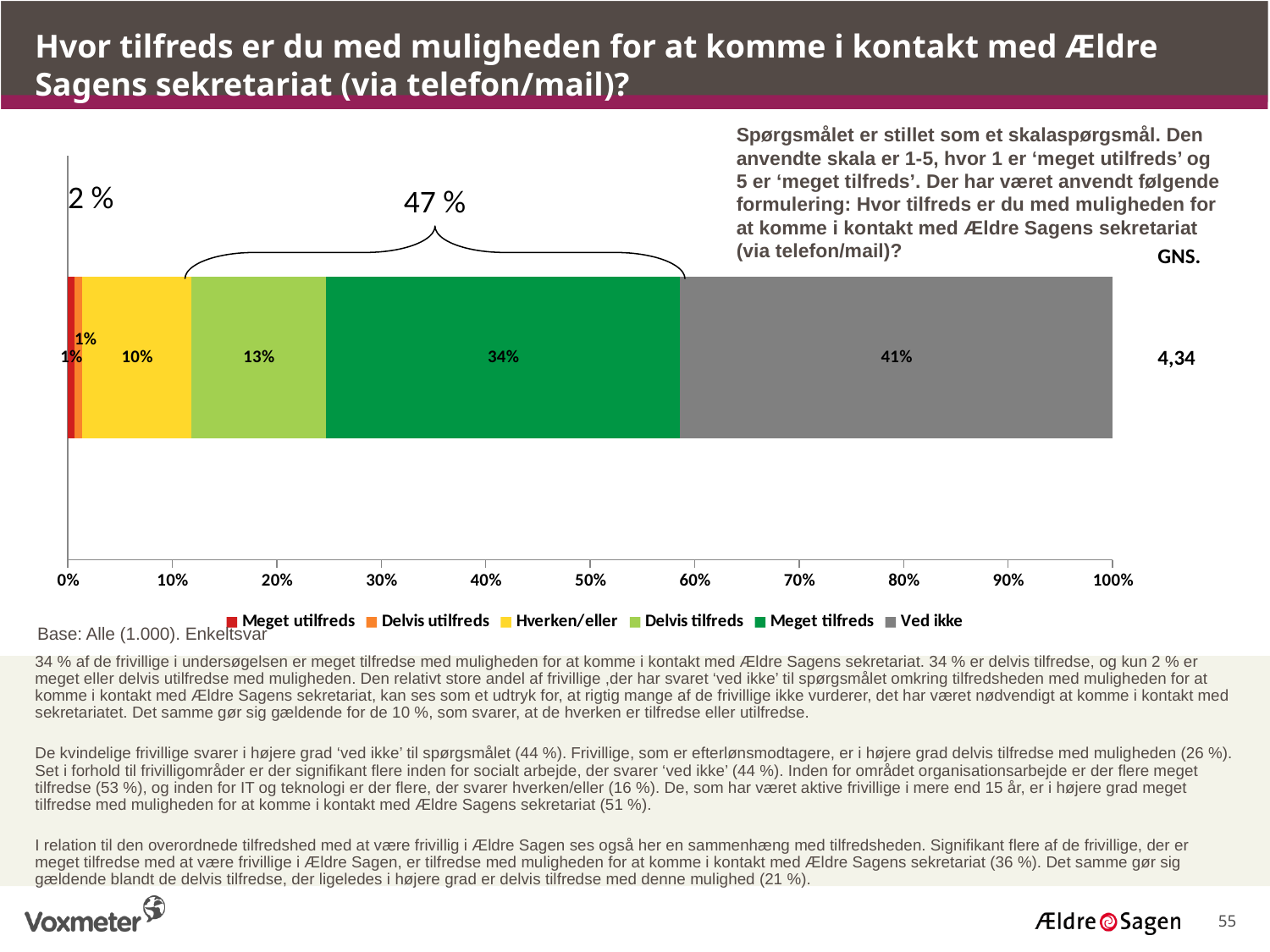
What is the combined share of 'Delvis tilfreds' and 'Meget tilfreds' as shown by the bracket above the bar? 47 % Which is larger, the share for 'Delvis tilfreds' or the share for 'Hverken/eller'? Delvis tilfreds What is the difference in percentage points between 'Ved ikke' and 'Meget tilfreds'? 7 Which response category has the largest share of the bar? Ved ikke What percentage of respondents answered 'Hverken/eller'? 10% What kind of chart is shown on the slide? Stacked bar chart What percentage of respondents answered 'Meget tilfreds'? 34% What average (GNS.) value is shown to the right of the bar? 4,34 What colour is the 'Meget tilfreds' segment in the legend? Dark green How many series does the legend list? 6 What percentage of respondents answered 'Ved ikke'? 41% What percentage of respondents answered 'Delvis tilfreds'? 13%